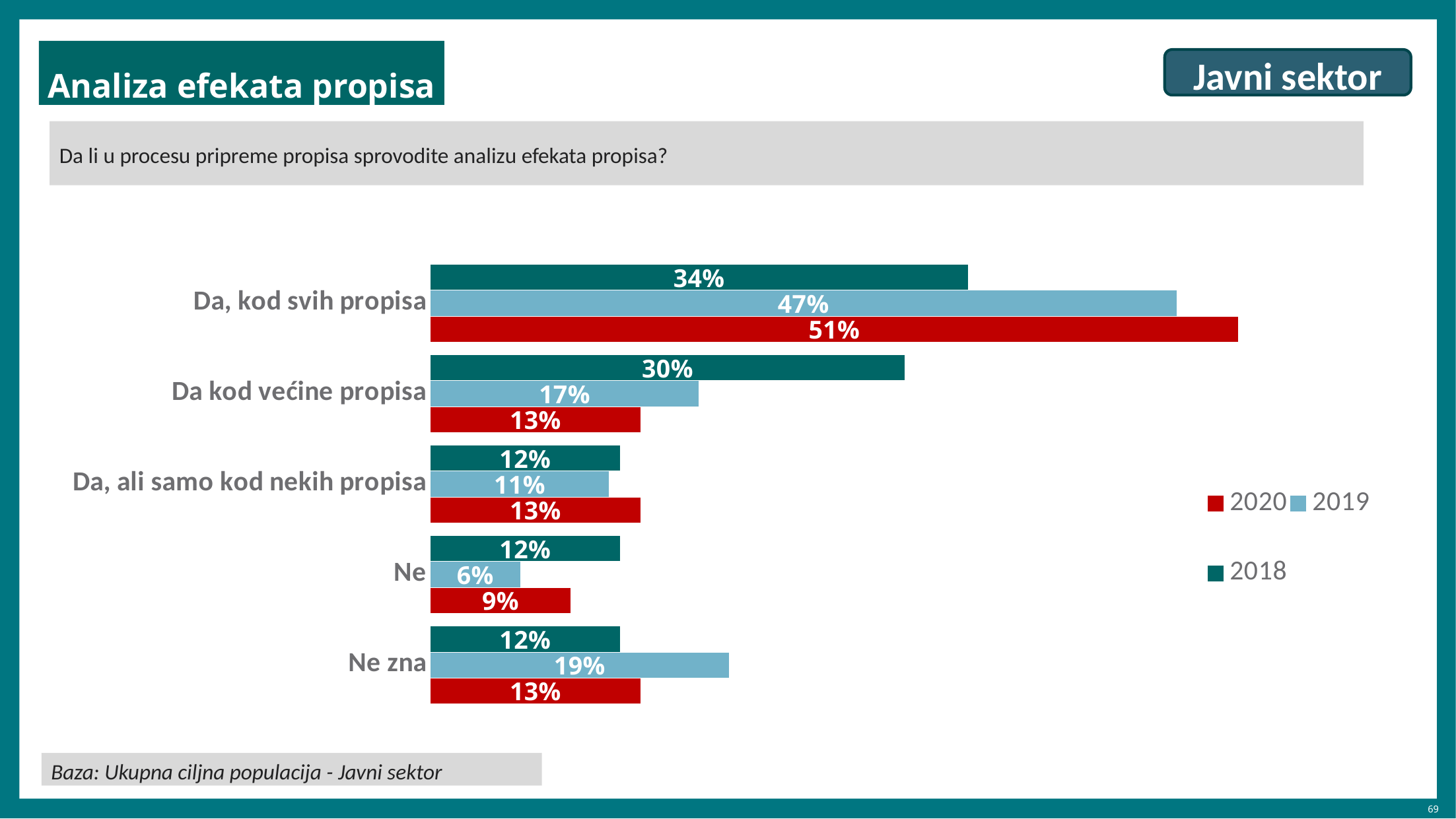
What is the value for "Ne zna" in the 2019 series? 19% What is the value for "Da kod većine propisa" in the 2018 series? 30% Which category has the highest value in the 2020 series? Da, kod svih propisa What kind of chart is shown on the slide? Bar chart What is the value for "Da, kod svih propisa" in the 2020 series? 51% Which colour represents the 2018 series in the legend? Dark teal Which category has the lowest value in the 2019 series? Ne What is the value for "Ne" in the 2019 series? 6% How many series does the legend list? 3 How many categories are shown on the chart? 5 Which is larger for "Da kod većine propisa": the 2019 value or the 2020 value? 2019 What is the difference between the 2020 and 2018 values for "Da, kod svih propisa"? 17%